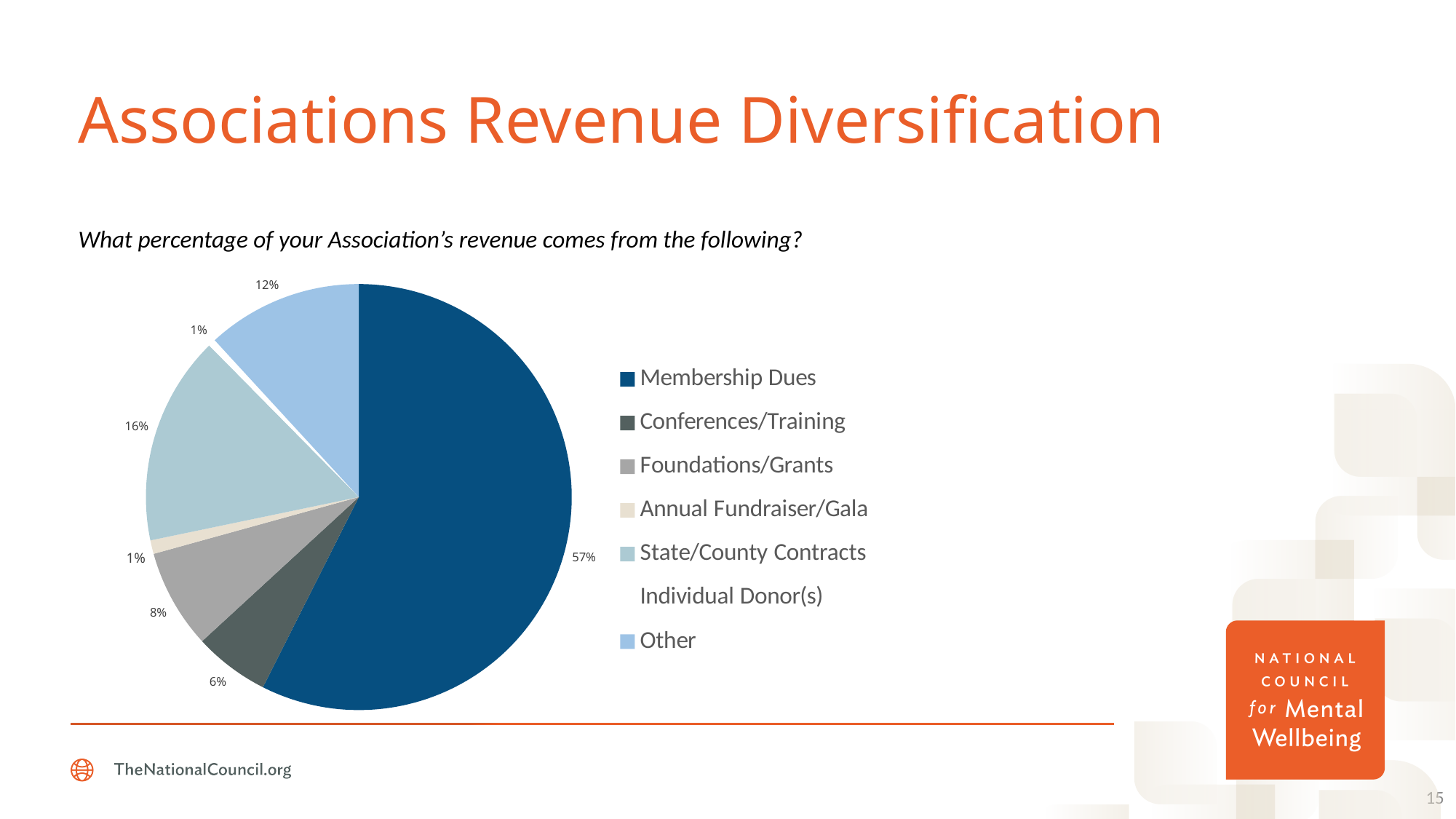
What percentage of revenue comes from Foundations/Grants? 8% Which is larger, the share for Foundations/Grants or the share for Conferences/Training? Foundations/Grants What percentage of revenue comes from State/County Contracts? 16% What is the difference between the Membership Dues share and the State/County Contracts share? 41% What question is the chart answering, as written above it? What percentage of your Association's revenue comes from the following? What kind of chart is shown on the slide? Pie chart What is the combined share of Other and State/County Contracts? 28% Which revenue source has the largest share of the pie? Membership Dues What percentage of revenue comes from Other? 12% How many revenue categories does the legend list? 7 What percentage of revenue comes from Membership Dues? 57% What percentage of revenue comes from Conferences/Training? 6%